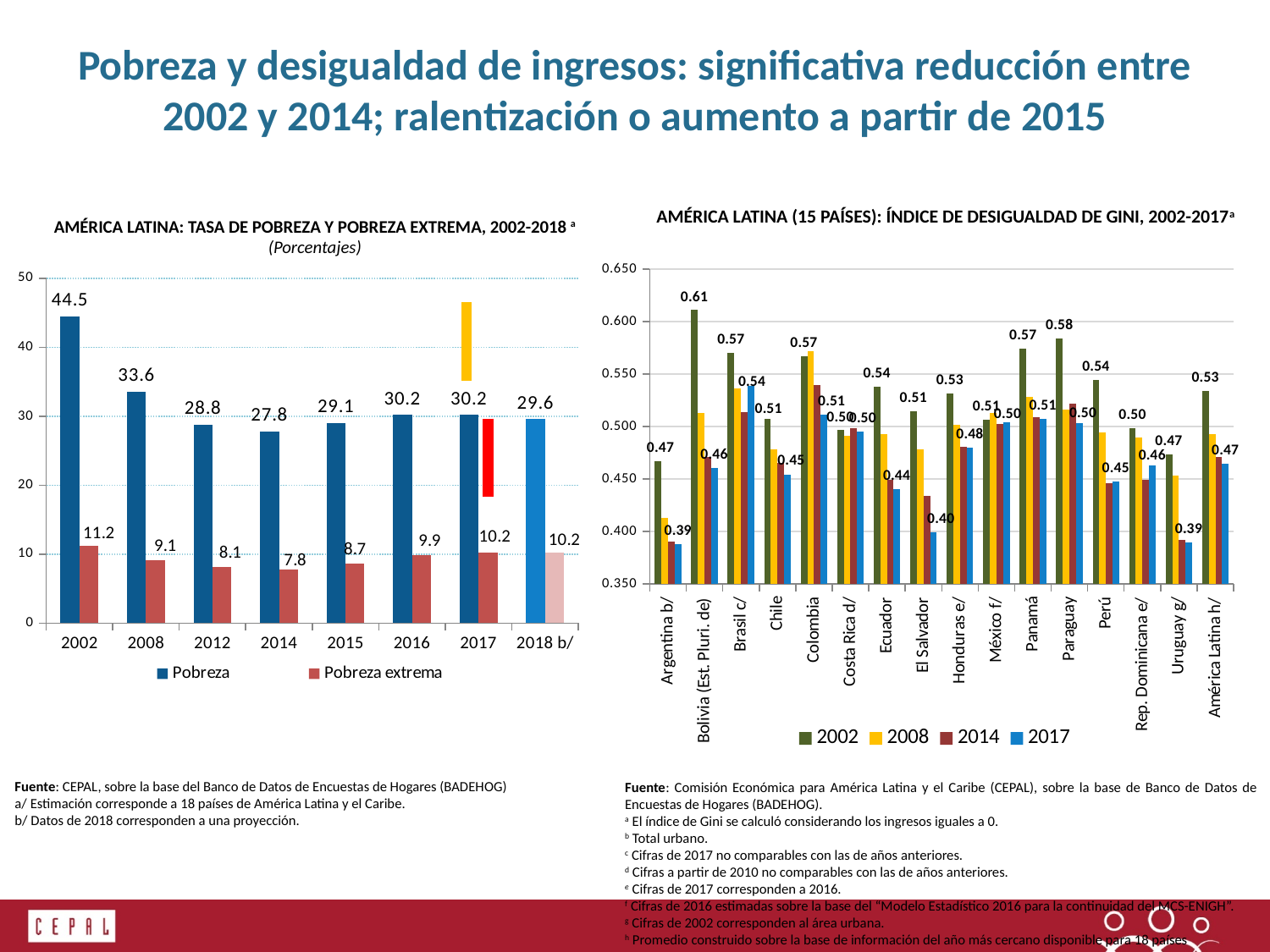
In the left chart (Tasa de pobreza y pobreza extrema), what is the Pobreza extrema value for 2014? 7.8 In the right chart (Índice de desigualdad de Gini), which country has the highest 2002 value? Bolivia (Est. Pluri. de) In the left chart (Tasa de pobreza y pobreza extrema), which year has the highest Pobreza value? 2002 In the left chart (Tasa de pobreza y pobreza extrema), what is the Pobreza value for 2002? 44.5 In the left chart (Tasa de pobreza y pobreza extrema), how many years are shown on the x axis? 8 In the right chart (Índice de desigualdad de Gini), which is larger, the 2002 value for Bolivia (Est. Pluri. de) or the 2002 value for Brasil c/? Bolivia (Est. Pluri. de) In the left chart (Tasa de pobreza y pobreza extrema), what is the difference between the Pobreza values for 2002 and 2014? 16.7 In the right chart (Índice de desigualdad de Gini), what is the 2017 value for Uruguay g/? 0.39 In the right chart (Índice de desigualdad de Gini), what is the 2002 value for Bolivia (Est. Pluri. de)? 0.61 In the left chart (Tasa de pobreza y pobreza extrema), which year has the lowest Pobreza extrema value? 2014 In the left chart (Tasa de pobreza y pobreza extrema), does the Pobreza value rise or fall from 2002 to 2014? fall In the right chart (Índice de desigualdad de Gini), how many series does the legend list? 4